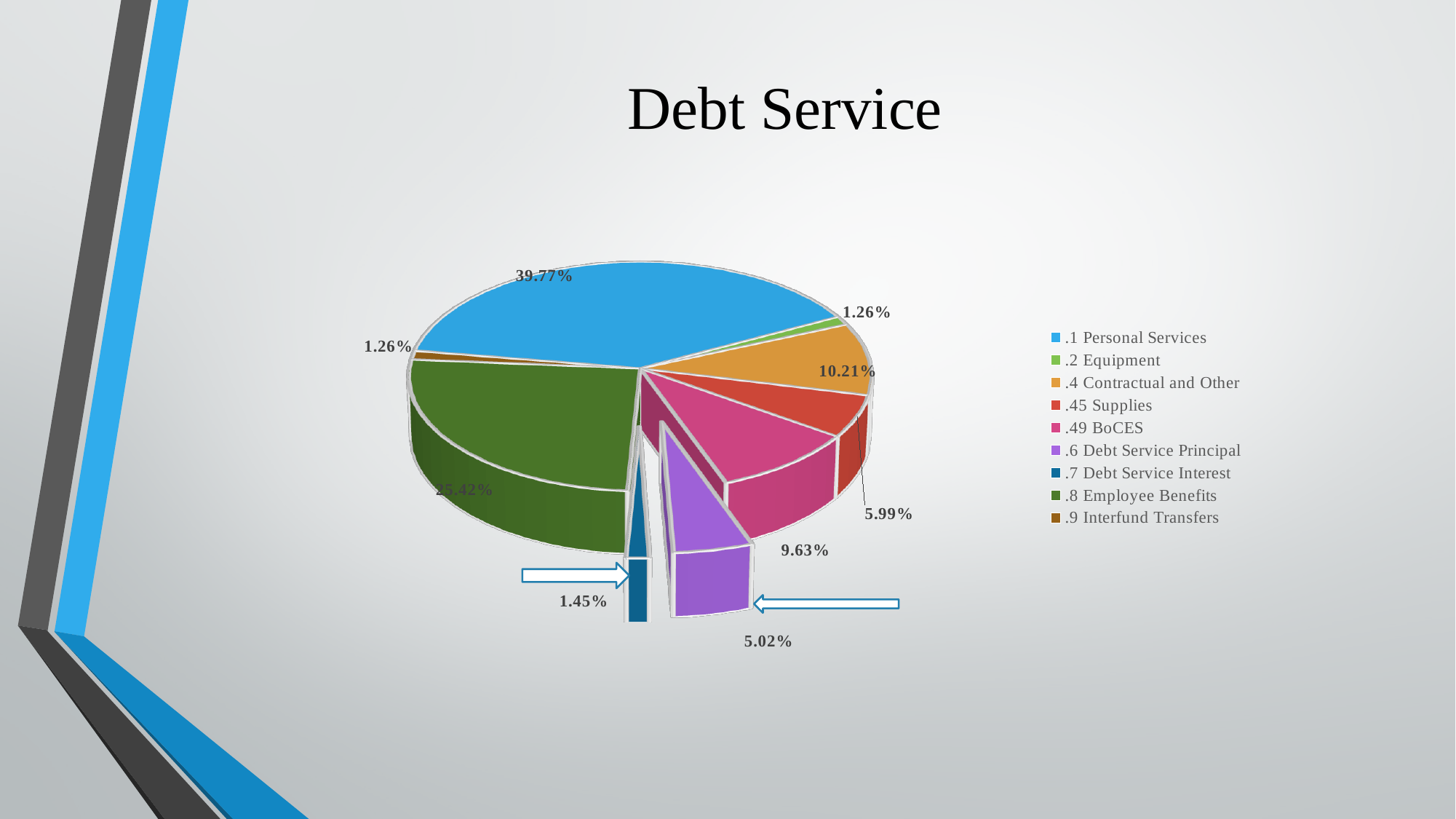
What is the combined share of .6 Debt Service Principal and .7 Debt Service Interest? 6.47% What share of the pie is .1 Personal Services? 39.77% What share of the pie is .4 Contractual and Other? 10.21% What share of the pie is .6 Debt Service Principal? 5.02% How many categories does the legend list? 9 Which category has the largest share of the pie? .1 Personal Services What share of the pie is .7 Debt Service Interest? 1.45% What is the title of the chart? Debt Service What is the difference between the shares of .1 Personal Services and .8 Employee Benefits? 14.35% Which is larger, .49 BoCES or .45 Supplies? .49 BoCES What type of chart is shown on the slide? pie chart What share of the pie is .8 Employee Benefits? 25.42%